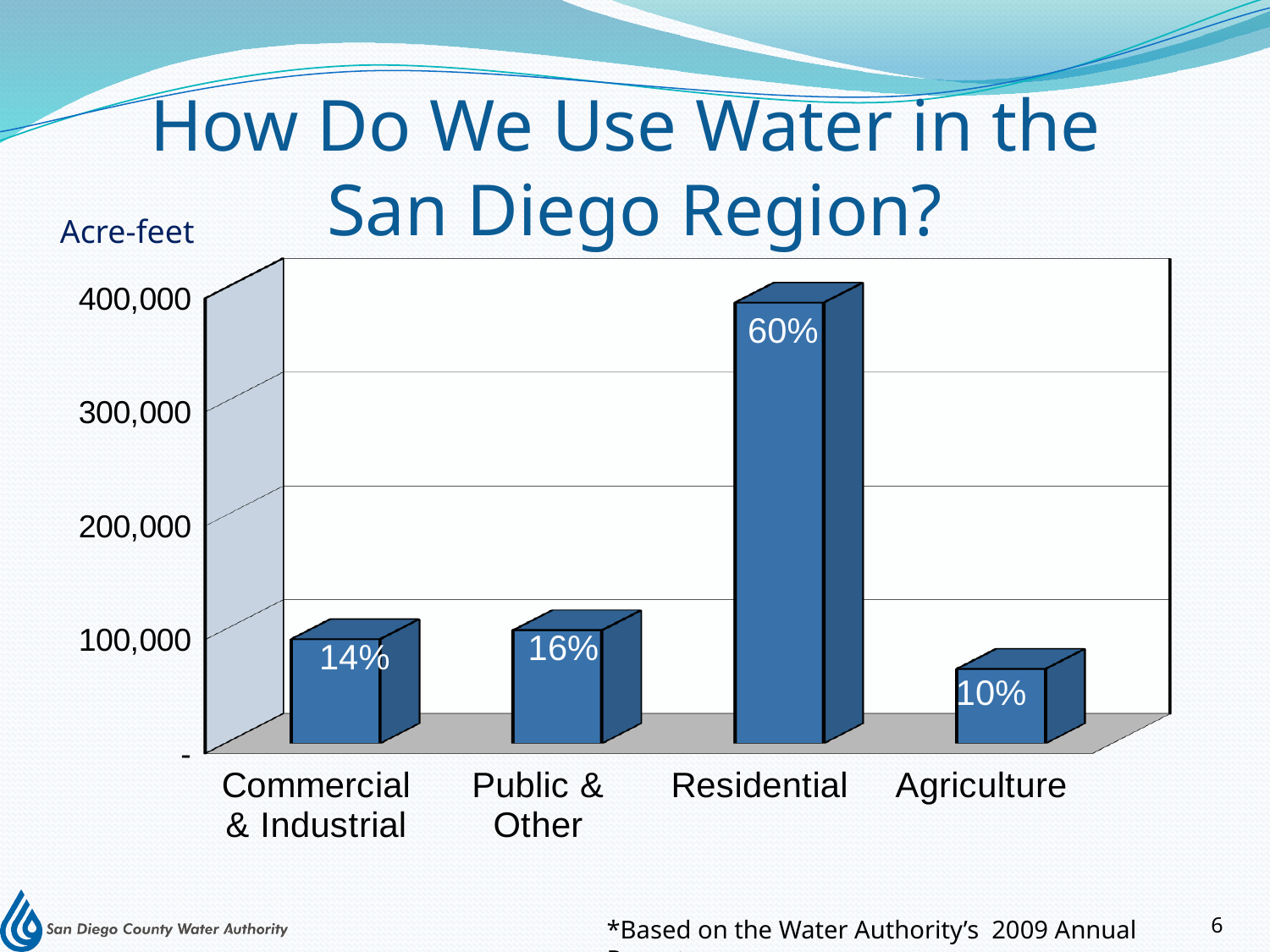
How many categories are shown on the chart? 4 Is the value for Residential greater or less than 300,000? greater Which category has the highest water use? Residential What unit is the vertical axis measured in? Acre-feet Is the value for Agriculture greater or less than 100,000? less What is the difference in percentage points between the Residential and Agriculture labels? 50 percentage points Which category has the lowest water use? Agriculture What percentage label is shown on the Commercial & Industrial bar? 14% Which is larger, the value for Public & Other or the value for Commercial & Industrial? Public & Other What percentage label is shown on the Residential bar? 60% What percentage label is shown on the Agriculture bar? 10% What percentage label is shown on the Public & Other bar? 16%